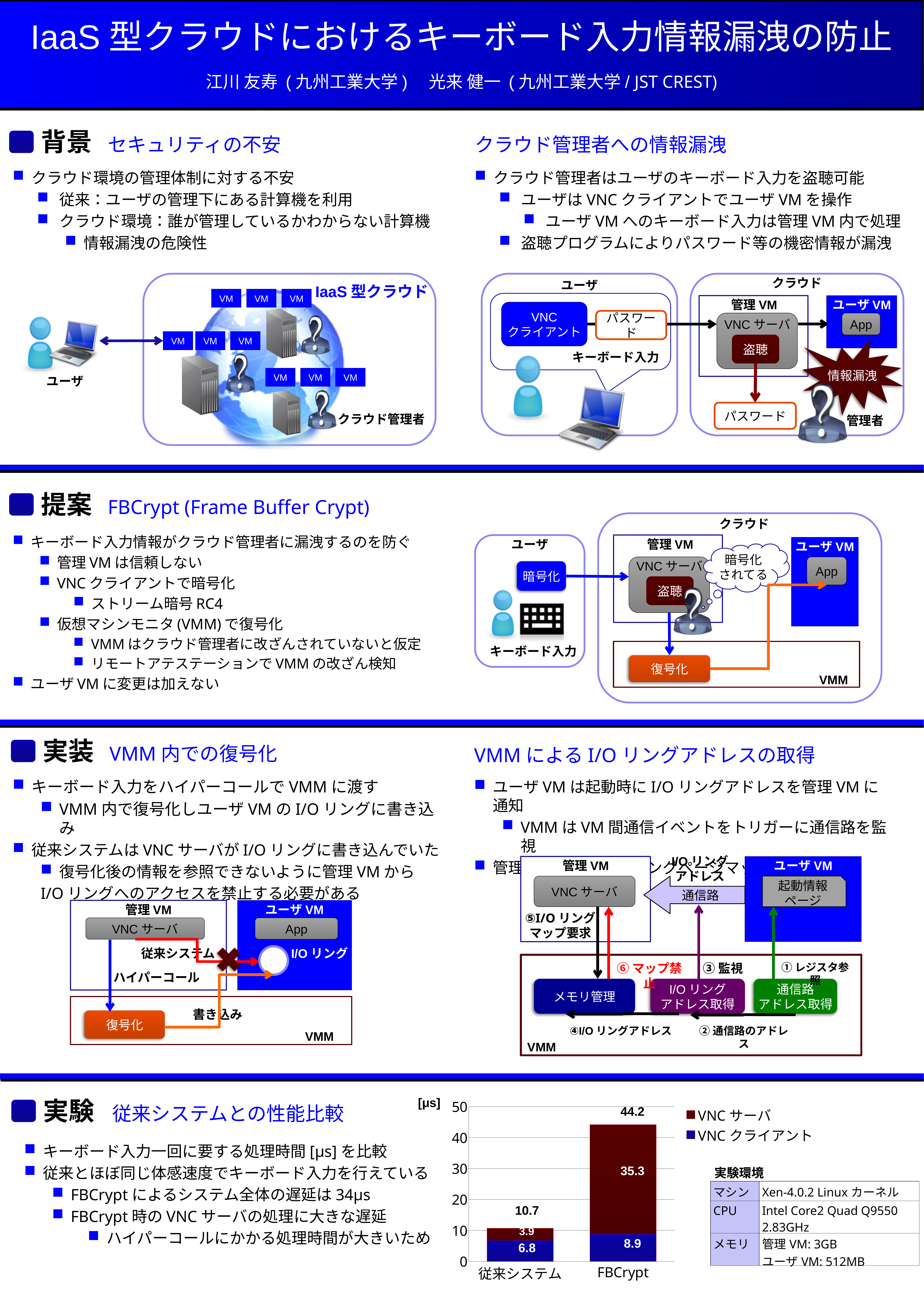
In the bar chart, what is the total of the stacked bar for 従来システム? 10.7 In the bar chart, what is the VNC クライアント value for FBCrypt? 8.9 In the bar chart, which category has the higher total processing time? FBCrypt In the bar chart, what is the VNC クライアント value for 従来システム? 6.8 What kind of chart is shown in the 実験 section? bar chart In the bar chart, what is the VNC サーバ value for FBCrypt? 35.3 What unit is shown on the y axis of the bar chart? [μs] In the bar chart, what is the difference between the VNC サーバ values for FBCrypt and 従来システム? 31.4 How many series does the legend of the bar chart list? 2 In the bar chart, what is the VNC サーバ value for 従来システム? 3.9 In the bar chart, is the VNC サーバ value for FBCrypt greater or less than 30? greater In the bar chart, what is the total of the stacked bar for FBCrypt? 44.2